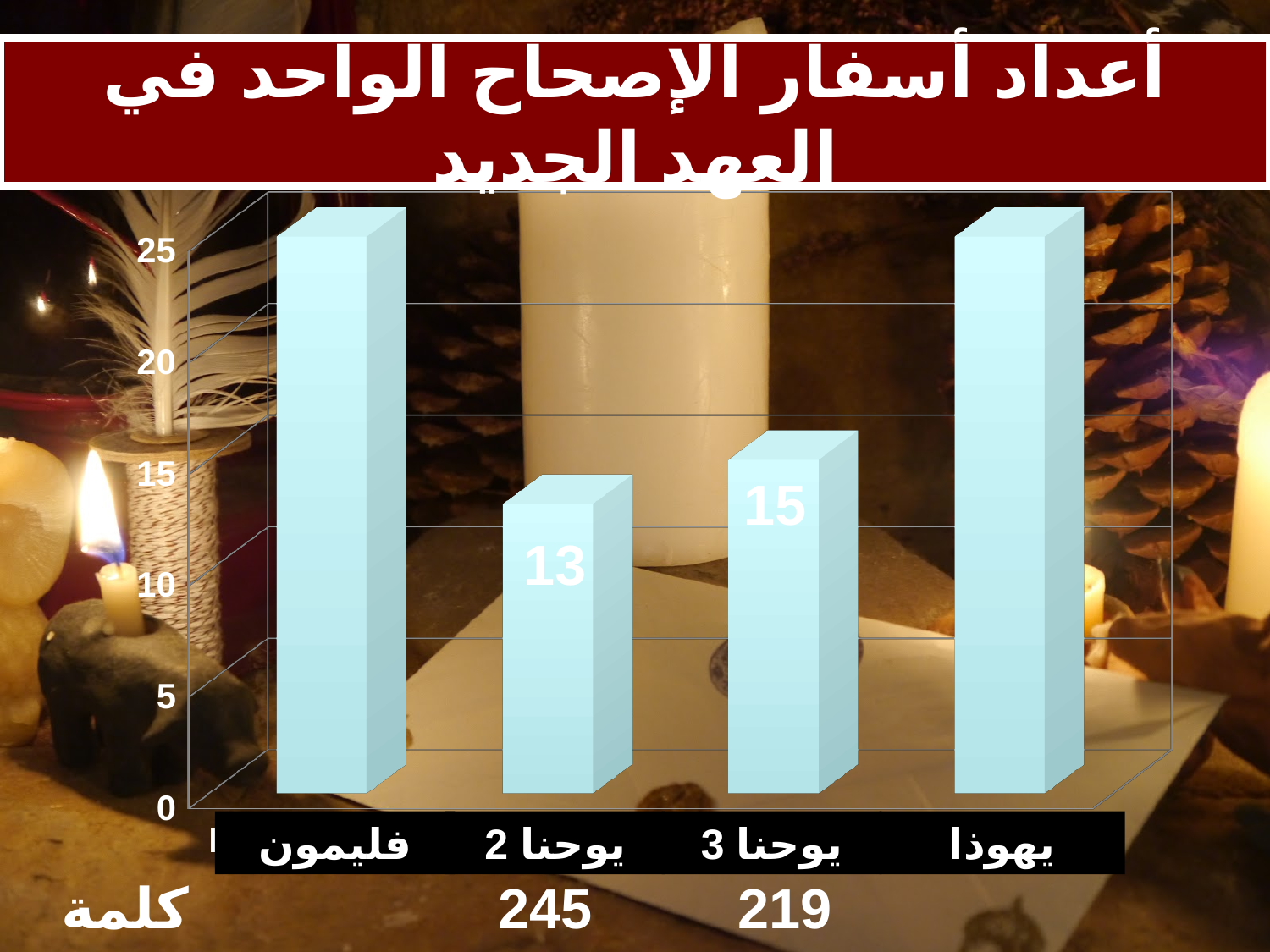
Is the value for فليمون greater or less than 20? greater Is the value for يهوذا greater or less than 20? greater What is the value for يوحنا 3? 15 What is the highest tick value shown on the vertical axis? 25 Which category has the lowest value? يوحنا 2 What kind of chart is shown on the slide? bar chart How many categories are shown on the x axis? 4 What is the difference between the values for يوحنا 3 and يوحنا 2? 2 Is the value for يوحنا 2 greater or less than 15? less Which is larger, the value for يوحنا 2 or the value for يوحنا 3? يوحنا 3 What is the title of the slide? أعداد أسفار الإصحاح الواحد في العهد الجديد What is the value for يوحنا 2? 13